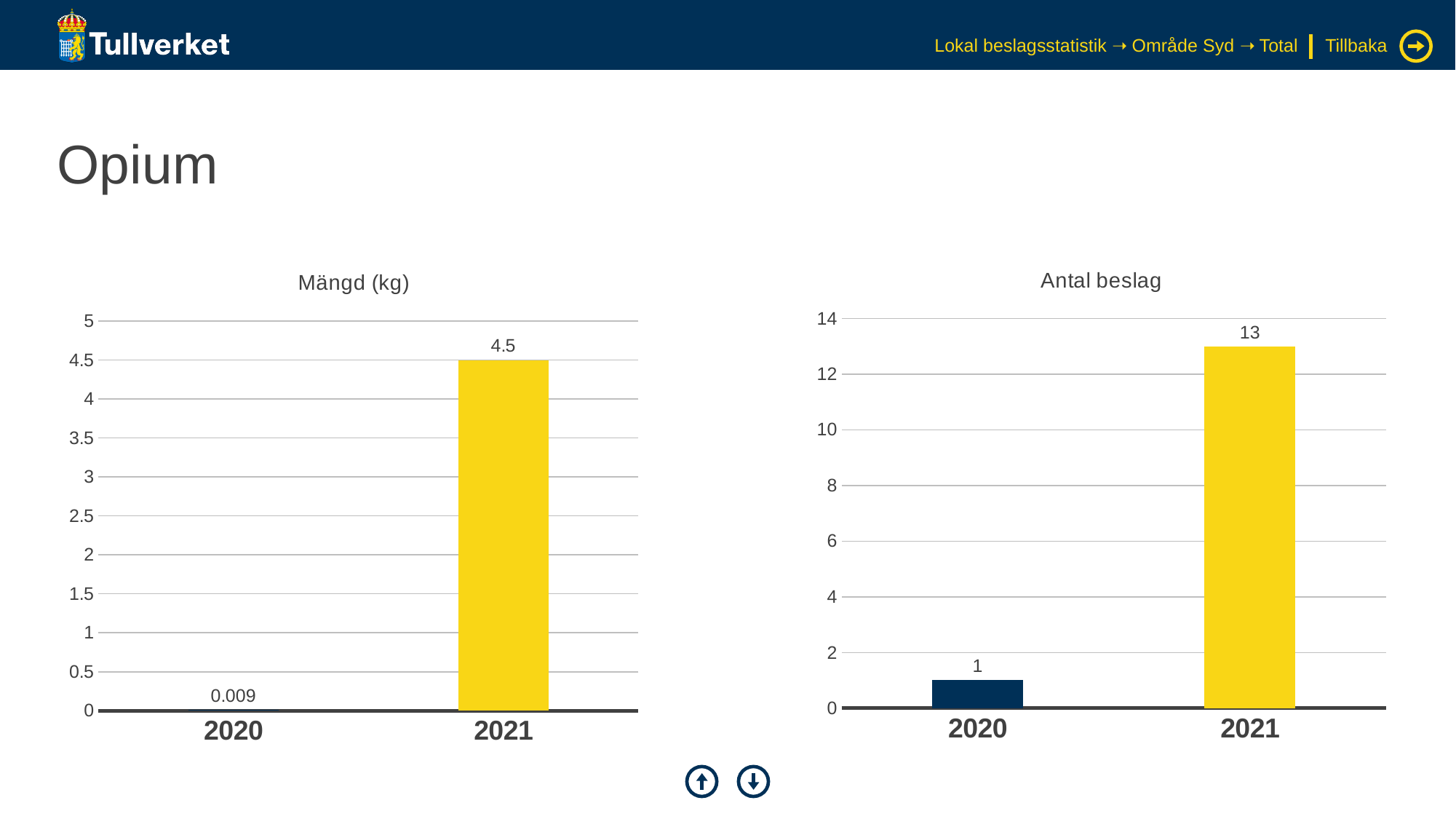
In the 'Mängd (kg)' chart, what is the value for 2020? 0.009 What is the title of the slide? Opium In the 'Mängd (kg)' chart, which year has the lowest value? 2020 In the 'Antal beslag' chart, what is the value for 2020? 1 In the 'Antal beslag' chart, is the value for 2021 greater or less than 12? greater How many categories are shown in the 'Mängd (kg)' chart? 2 In the 'Mängd (kg)' chart, what is the value for 2021? 4.5 In the 'Antal beslag' chart, what is the value for 2021? 13 What kind of chart is the 'Antal beslag' chart? bar chart In the 'Antal beslag' chart, what is the difference between the values for 2021 and 2020? 12 In the 'Mängd (kg)' chart, which is larger, the value for 2020 or the value for 2021? 2021 In the 'Antal beslag' chart, which year has the highest value? 2021